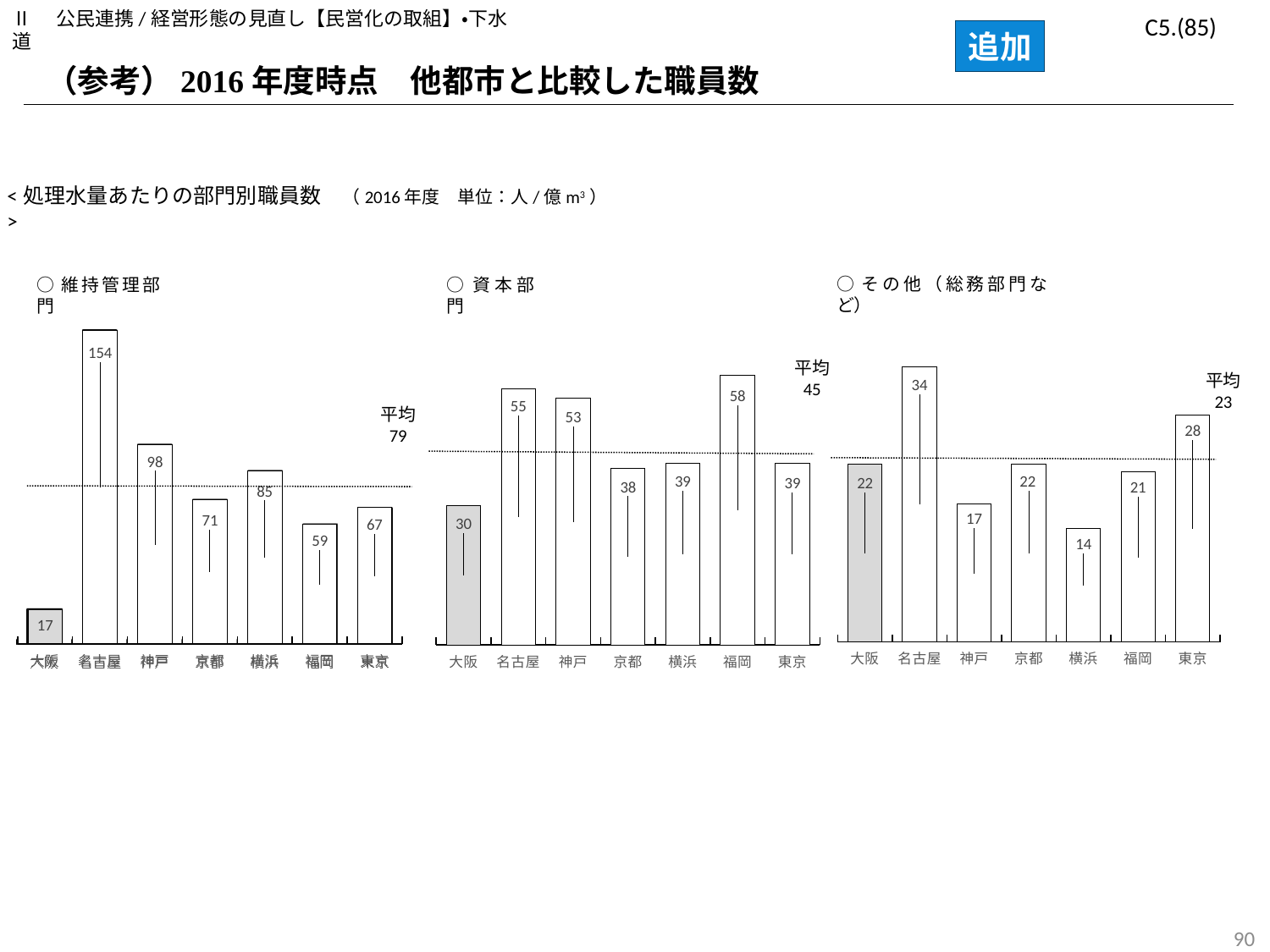
In the その他 chart (right), which city has the highest value? 名古屋 In the 資本部門 chart (middle), which city has the highest value? 福岡 In the 資本部門 chart (middle), which is larger, the value for 大阪 or the value for 京都? 京都 In the その他 chart (right), what is the difference between 東京 and 神戸? 11 In the 資本部門 chart (middle), how many cities are shown? 7 What kind of chart is used for the 維持管理部門 data on the left? Bar chart In the 維持管理部門 chart (left), what average (平均) value is shown? 79 In the 維持管理部門 chart (left), what is the difference between 神戸 and 京都? 27 In the 維持管理部門 chart (left), what is the value for 名古屋? 154 In the 維持管理部門 chart (left), which city has the lowest value? 大阪 In the その他 chart (right), what is the value for 横浜? 14 In the 資本部門 chart (middle), what is the value for 福岡? 58